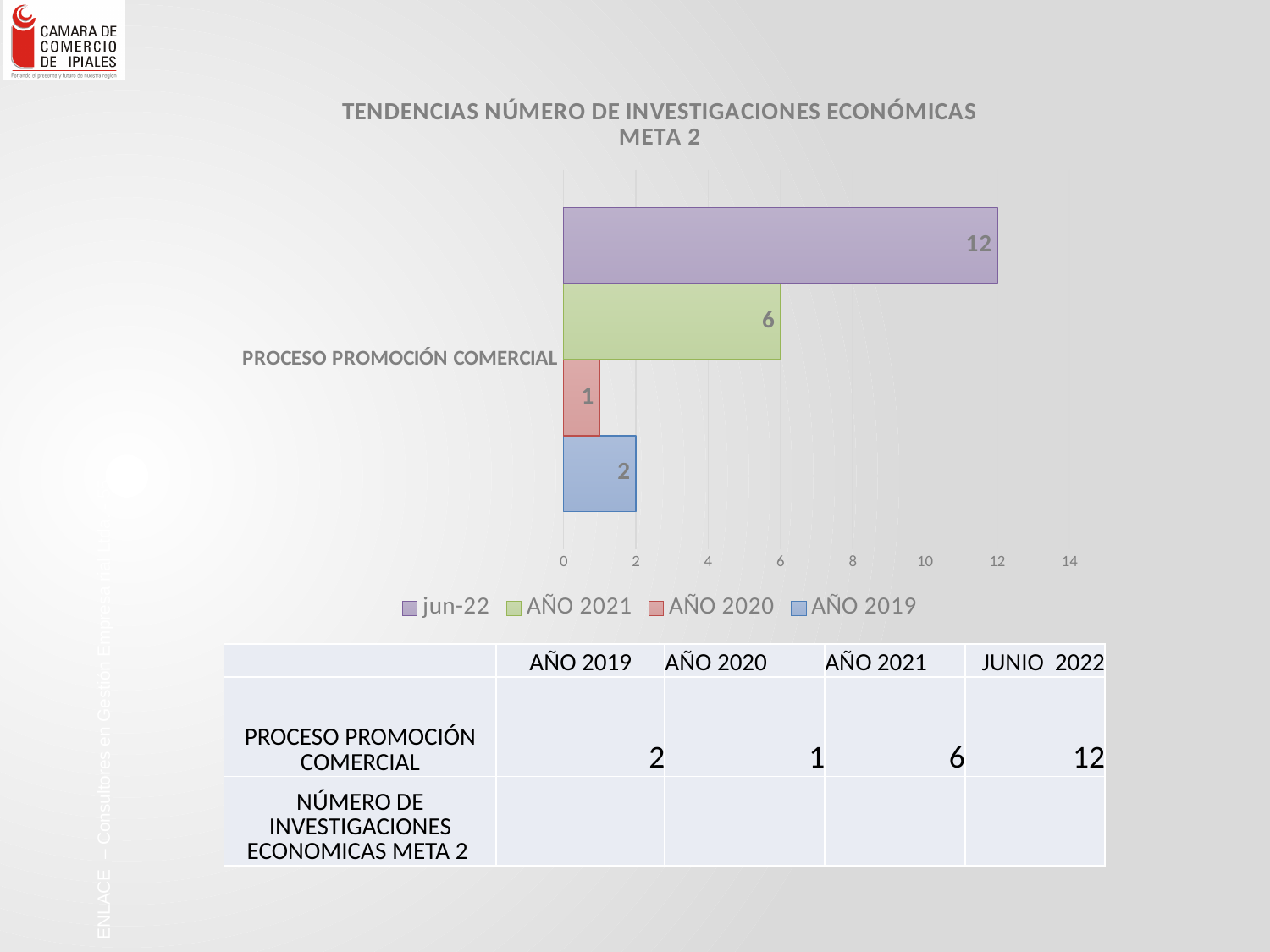
Which series has the highest value in the chart? jun-22 Which is larger, the value for AÑO 2019 or the value for AÑO 2020? AÑO 2019 What category label is shown on the vertical axis of the chart? PROCESO PROMOCIÓN COMERCIAL What is the value for AÑO 2020 in the chart? 1 What is the title of the chart? TENDENCIAS NÚMERO DE INVESTIGACIONES ECONÓMICAS META 2 What is the value for jun-22 in the chart? 12 What is the value for AÑO 2021 in the chart? 6 What is the difference between the jun-22 value and the AÑO 2021 value? 6 What is the value for AÑO 2019 in the chart? 2 Which series has the lowest value in the chart? AÑO 2020 What kind of chart is shown on the slide? Bar chart How many series does the legend list? 4